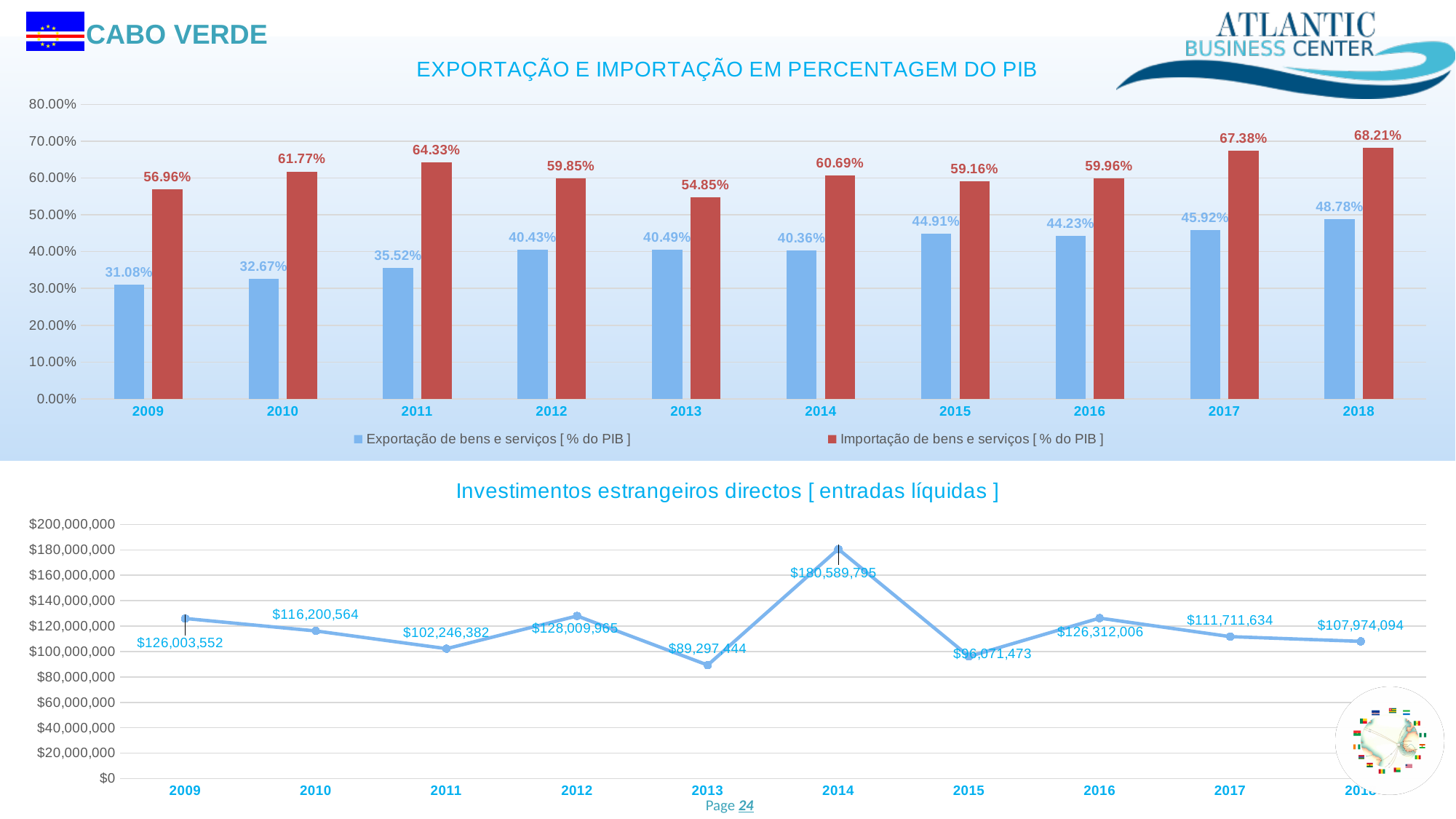
In the chart 'EXPORTAÇÃO E IMPORTAÇÃO EM PERCENTAGEM DO PIB', how many series does the legend list? 2 In the chart 'Investimentos estrangeiros directos [ entradas líquidas ]', how many years are plotted? 10 In the chart 'EXPORTAÇÃO E IMPORTAÇÃO EM PERCENTAGEM DO PIB', what is the value of Exportação de bens e serviços for 2011? 35.52% In the chart 'EXPORTAÇÃO E IMPORTAÇÃO EM PERCENTAGEM DO PIB', what is the difference between Importação and Exportação in 2018? 19.43% In the chart 'EXPORTAÇÃO E IMPORTAÇÃO EM PERCENTAGEM DO PIB', what is the value of Importação de bens e serviços for 2013? 54.85% In the chart 'EXPORTAÇÃO E IMPORTAÇÃO EM PERCENTAGEM DO PIB', which year has the highest Importação de bens e serviços value? 2018 In the chart 'EXPORTAÇÃO E IMPORTAÇÃO EM PERCENTAGEM DO PIB', which year has the lowest Exportação de bens e serviços value? 2009 In the chart 'EXPORTAÇÃO E IMPORTAÇÃO EM PERCENTAGEM DO PIB', what kind of chart is it? Bar chart In the chart 'Investimentos estrangeiros directos [ entradas líquidas ]', which is larger, the value for 2016 or the value for 2017? 2016 In the chart 'Investimentos estrangeiros directos [ entradas líquidas ]', what is the value for 2014? $180,589,795 In the chart 'Investimentos estrangeiros directos [ entradas líquidas ]', which year has the lowest value? 2013 In the chart 'Investimentos estrangeiros directos [ entradas líquidas ]', what is the difference between the 2014 and 2013 values? $91,292,351